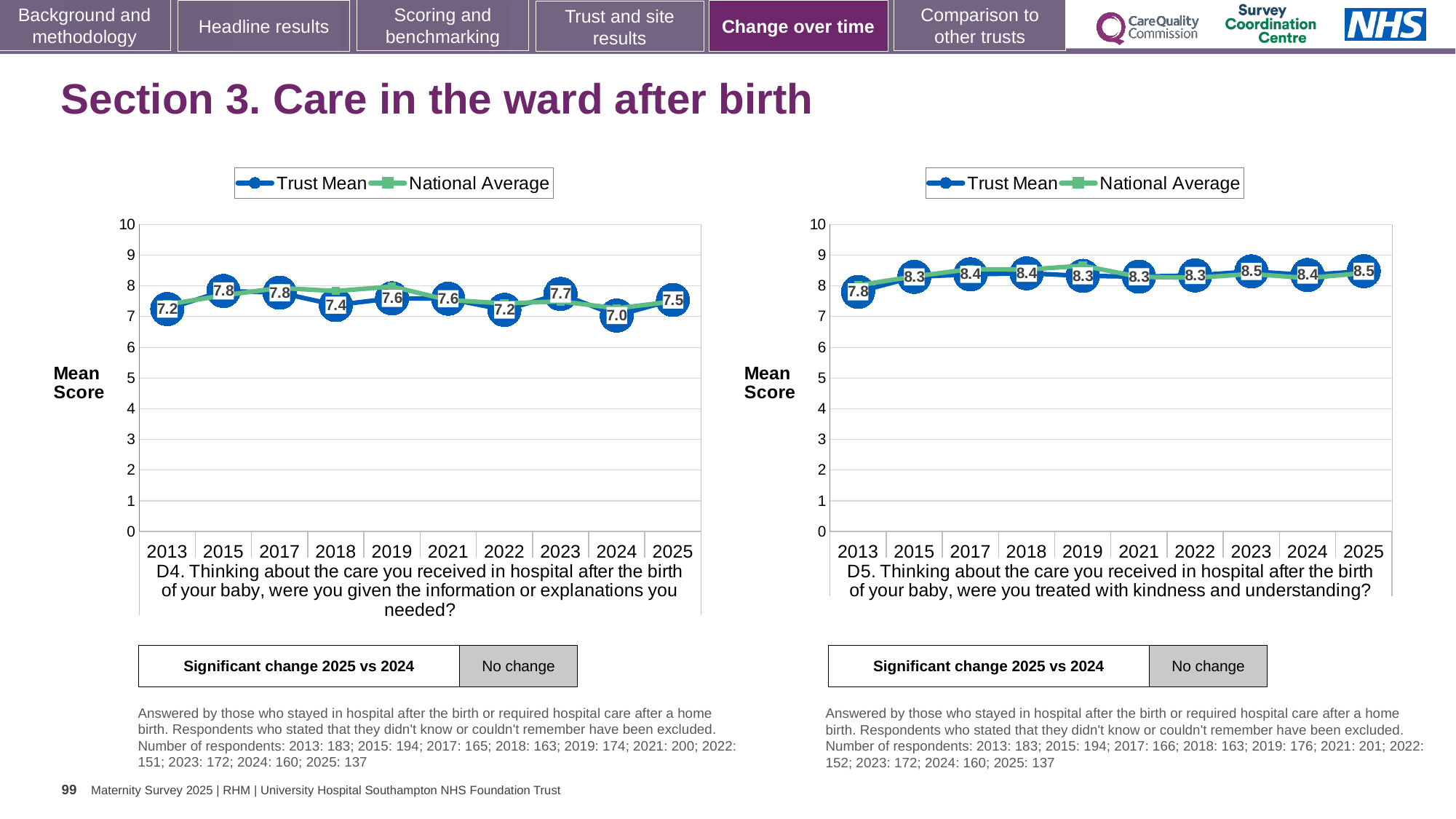
In the D4 chart on the left, which year has the higher Trust Mean score, 2015 or 2018? 2015 In the D4 chart on the left, what is the difference between the Trust Mean scores for 2025 and 2024? 0.5 How many series does the legend of the D5 chart on the right list? 2 In the D4 chart on the left, which year has the lowest Trust Mean score? 2024 How many years are plotted on the x axis of the D4 chart on the left? 10 In the D5 chart on the right, is the National Average for 2025 greater or less than 8? greater In the D5 chart on the right, which year has the lowest Trust Mean score? 2013 In the D5 chart on the right, what is the Trust Mean score for 2013? 7.8 In the D5 chart on the right, what does the box labelled 'Significant change 2025 vs 2024' say? No change In the D4 chart on the left, what is the Trust Mean score for 2024? 7.0 In the D5 chart on the right, what is the difference between the Trust Mean scores for 2025 and 2013? 0.7 What kind of chart is the D4 chart on the left? Line chart